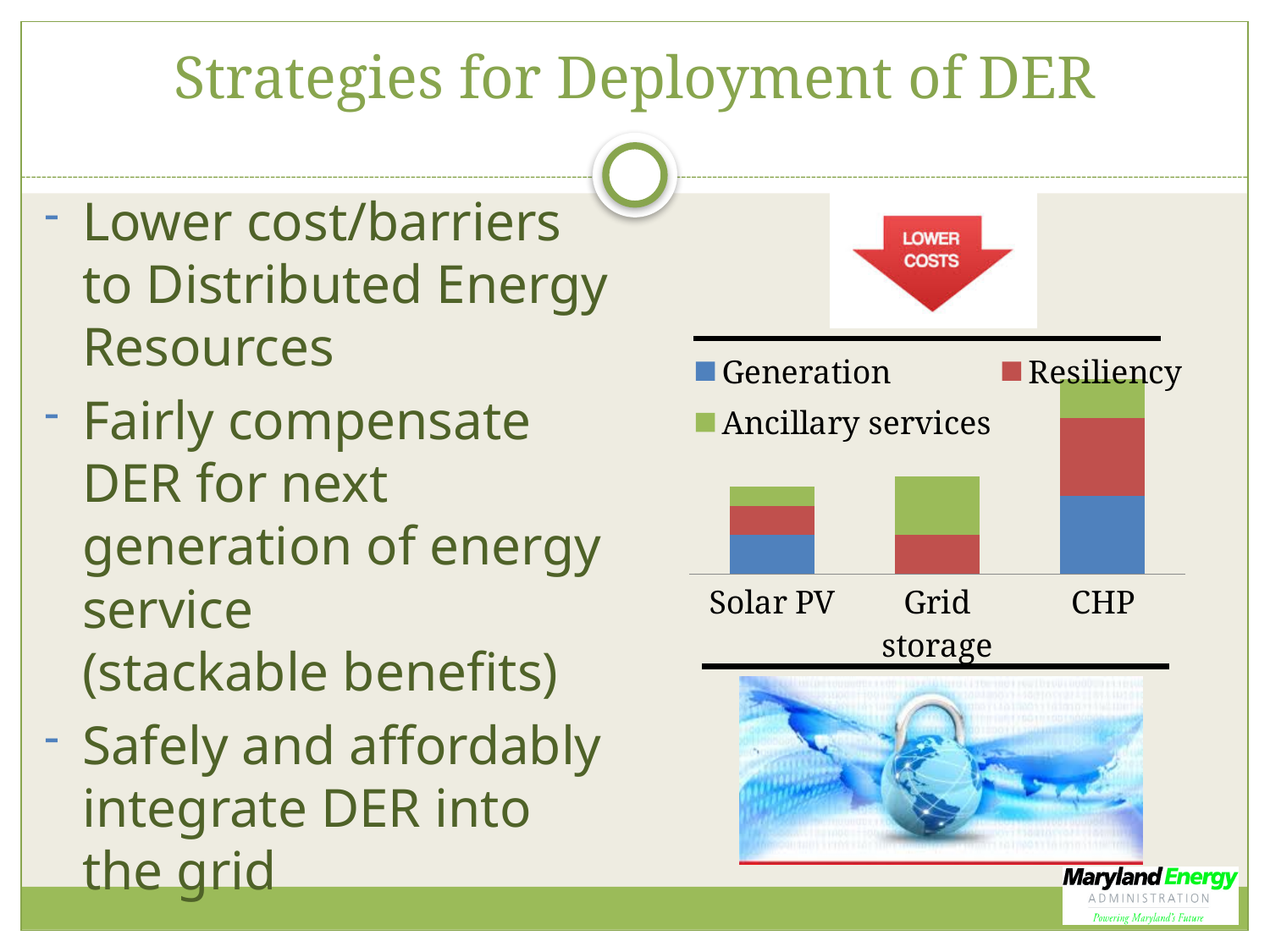
What colour represents the Resiliency series in the chart? Red What kind of chart is shown on the slide? Stacked bar chart How many categories are shown on the x axis of the chart? 3 What are the three series listed in the chart's legend? Generation, Resiliency, Ancillary services Which series is the smallest segment of the Solar PV bar? Ancillary services Which stacked bar is taller, CHP or Solar PV? CHP Which category has the tallest stacked bar in the chart? CHP Which category's bar has no Generation segment? Grid storage How many series does the chart's legend list? 3 Which series makes up the largest segment of the Grid storage bar? Ancillary services